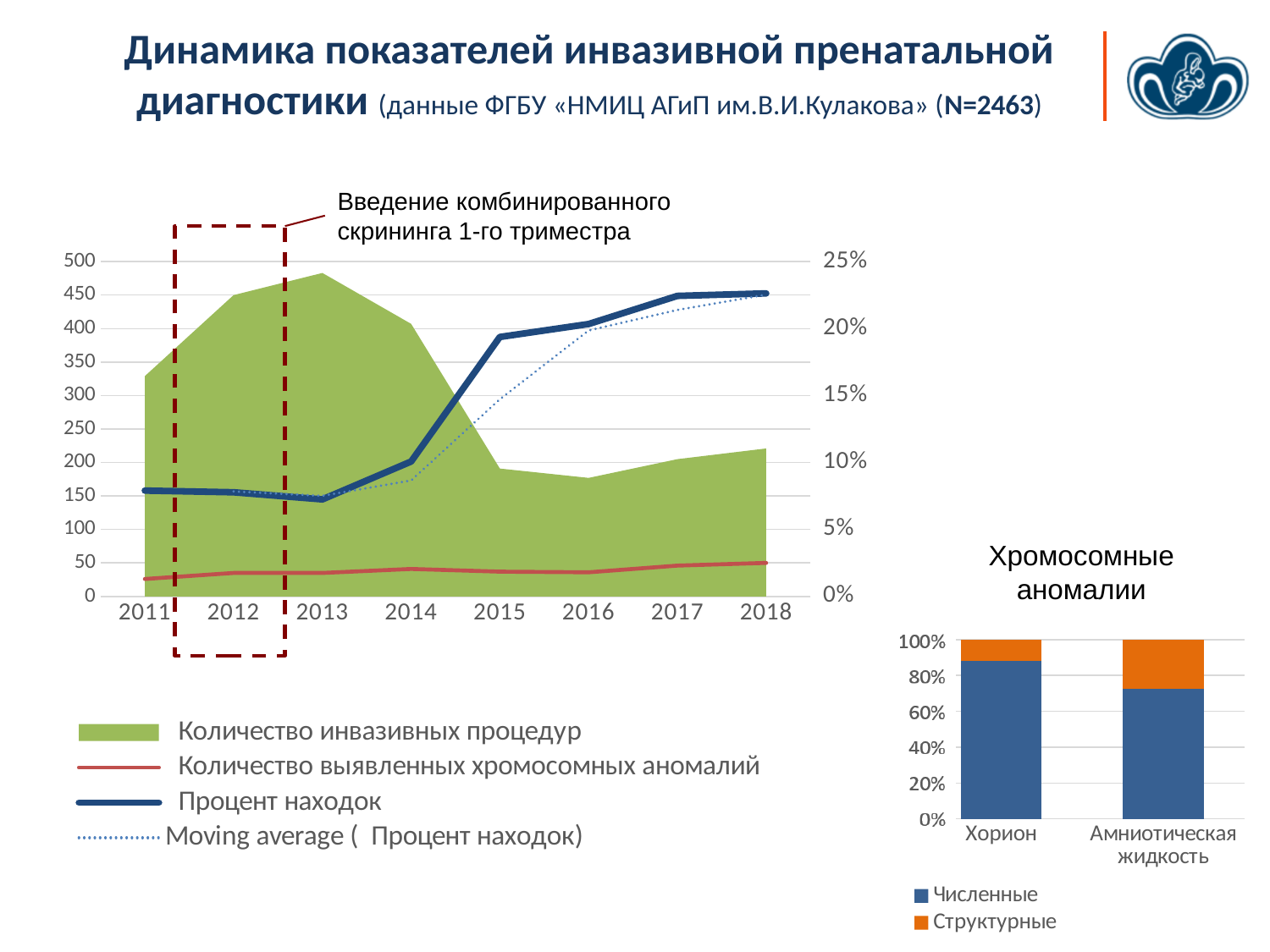
On the large chart on the left, is the value of Количество инвазивных процедур in 2011 greater or less than 300? greater On the large chart on the left, how many entries does the legend list? 4 On the large chart on the left, is the value of Процент находок in 2013 greater or less than 10%? less On the large chart on the left, does Количество инвазивных процедур rise or fall from 2013 to 2015? fall What kind of chart is the 'Хромосомные аномалии' chart? stacked bar chart On the large chart on the left, in which year is Количество инвазивных процедур highest? 2013 On the large chart on the left, how many years are shown along the x axis? 8 On the 'Хромосомные аномалии' chart, is the share of Численные for Хорион greater or less than 80%? greater On the 'Хромосомные аномалии' chart, how many series does the legend list? 2 On the large chart on the left, does Процент находок rise or fall from 2013 to 2018? rise